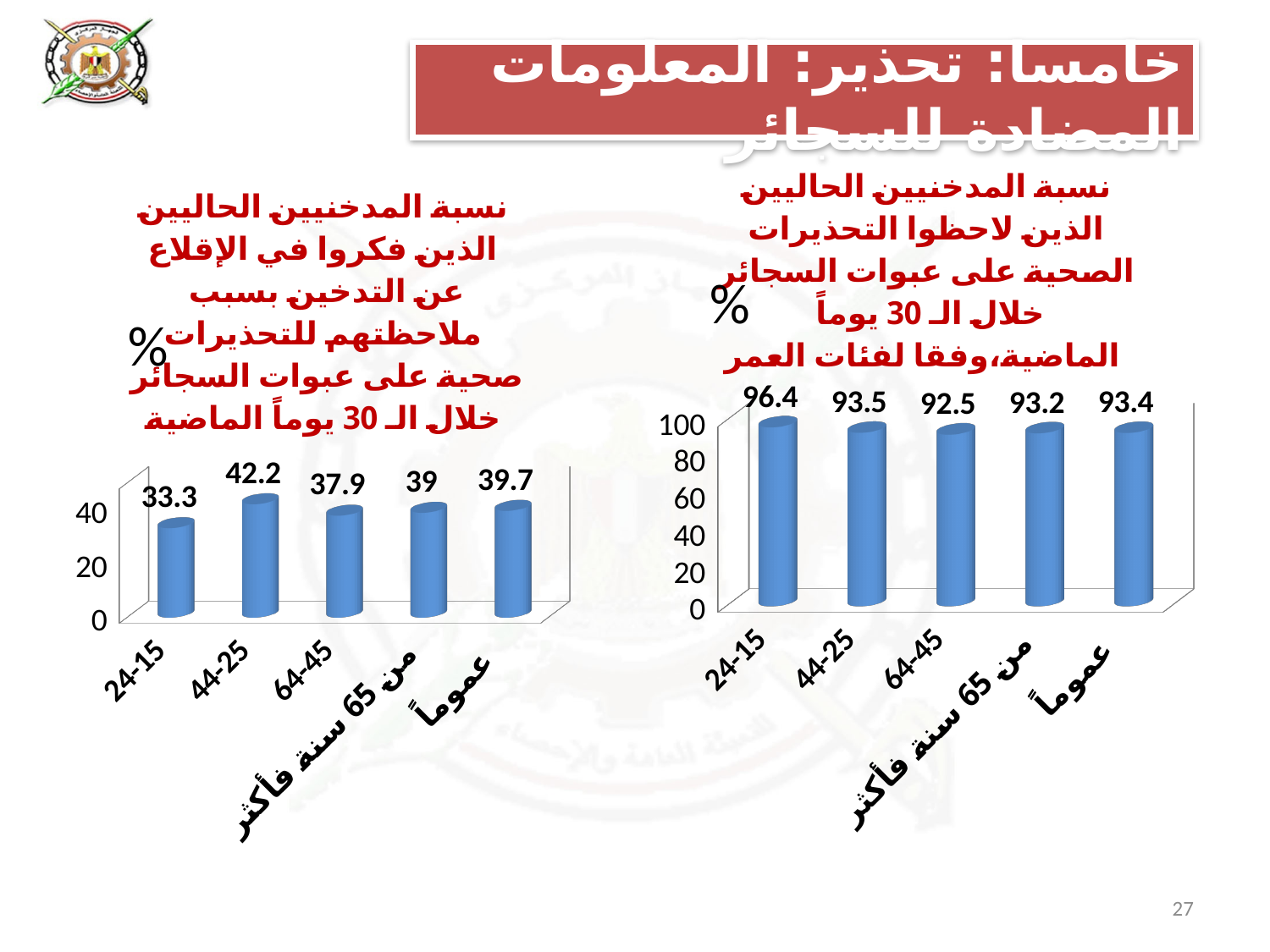
In the right chart, is the value for the 45-64 age group greater or less than 80? greater In the left chart (smokers who thought about quitting because of the warnings), is the value for the 65 and over group larger or smaller than the overall (عموماً) value? smaller In the right chart (smokers who noticed health warnings on cigarette packs), which age group has the lowest value? 45-64 What type of chart is the left chart? Bar chart In the left chart (smokers who thought about quitting because of the warnings), what is the value for the 25-44 age group? 42.2 In the left chart (smokers who thought about quitting because of the warnings), which age group has the highest value? 25-44 In the right chart (smokers who noticed health warnings on cigarette packs), what is the value for the 15-24 age group? 96.4 In the left chart (smokers who thought about quitting because of the warnings), which age group has the lowest value? 15-24 In the left chart (smokers who thought about quitting because of the warnings), what is the difference between the 25-44 group and the 15-24 group? 8.9 How many age categories are shown on the x axis of the right chart? 5 In the right chart (smokers who noticed health warnings on cigarette packs), what is the overall (عموماً) value? 93.4 In the right chart (smokers who noticed health warnings on cigarette packs), what is the difference between the 15-24 group and the 45-64 group? 3.9